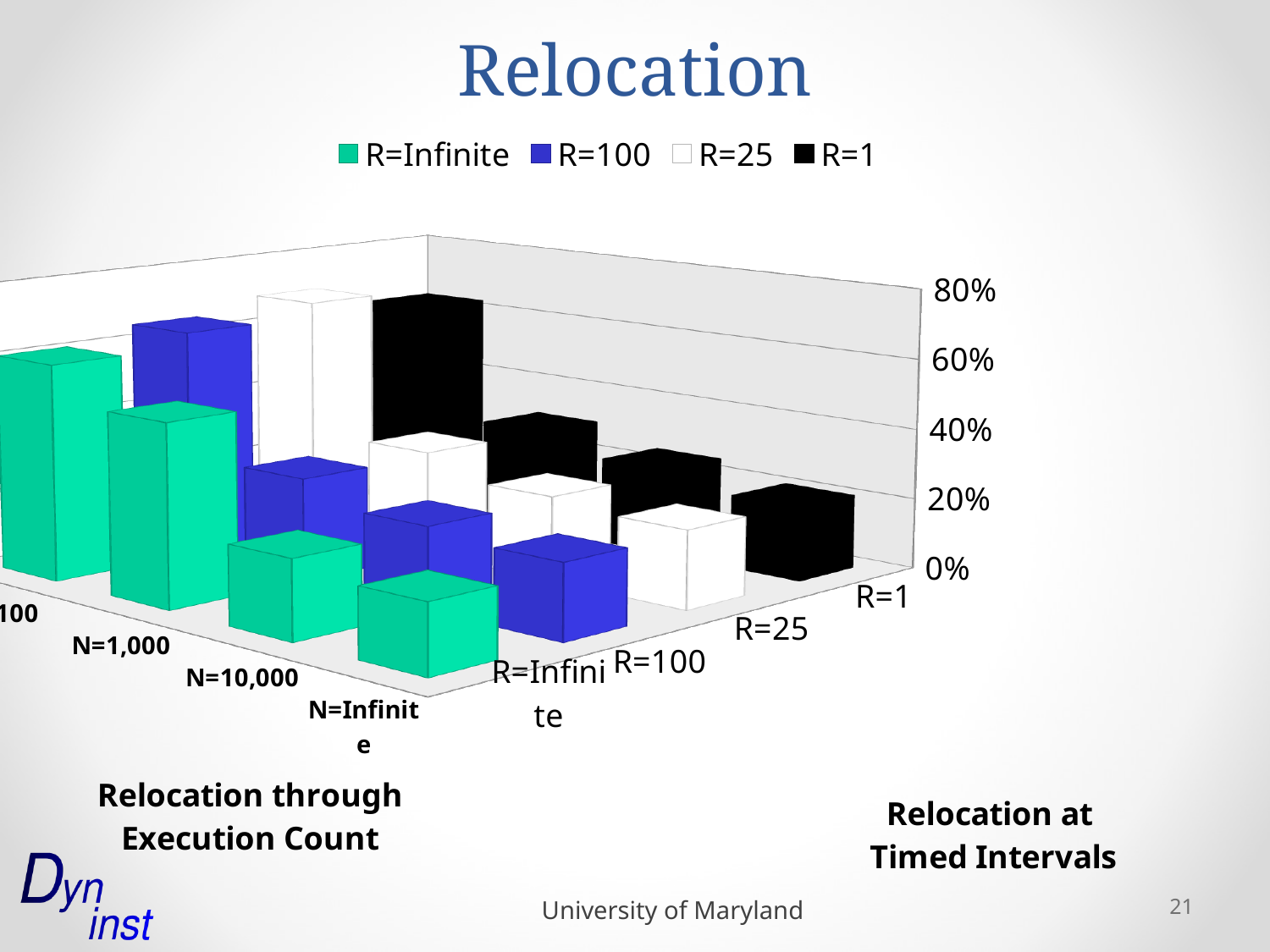
What is the highest percentage tick shown on the vertical axis? 80% For the R=Infinite series, do the values rise or fall as N increases from N=1,000 to N=Infinite? fall What kind of chart is shown on the slide? bar chart Within the R=Infinite series, which N category has the highest value? N=100 Which series is listed first in the legend? R=Infinite For the R=100 series, which is larger: the value at N=1,000 or the value at N=Infinite? N=1,000 How many series does the legend list? 4 How many N categories are plotted along the front axis? 4 For the R=1 series, do the values rise or fall as N increases along the axis? fall What colour represents the R=1 series? black Within the R=Infinite series, which N category has the lowest value? N=Infinite Within the R=1 series, which N category has the lowest value? N=Infinite